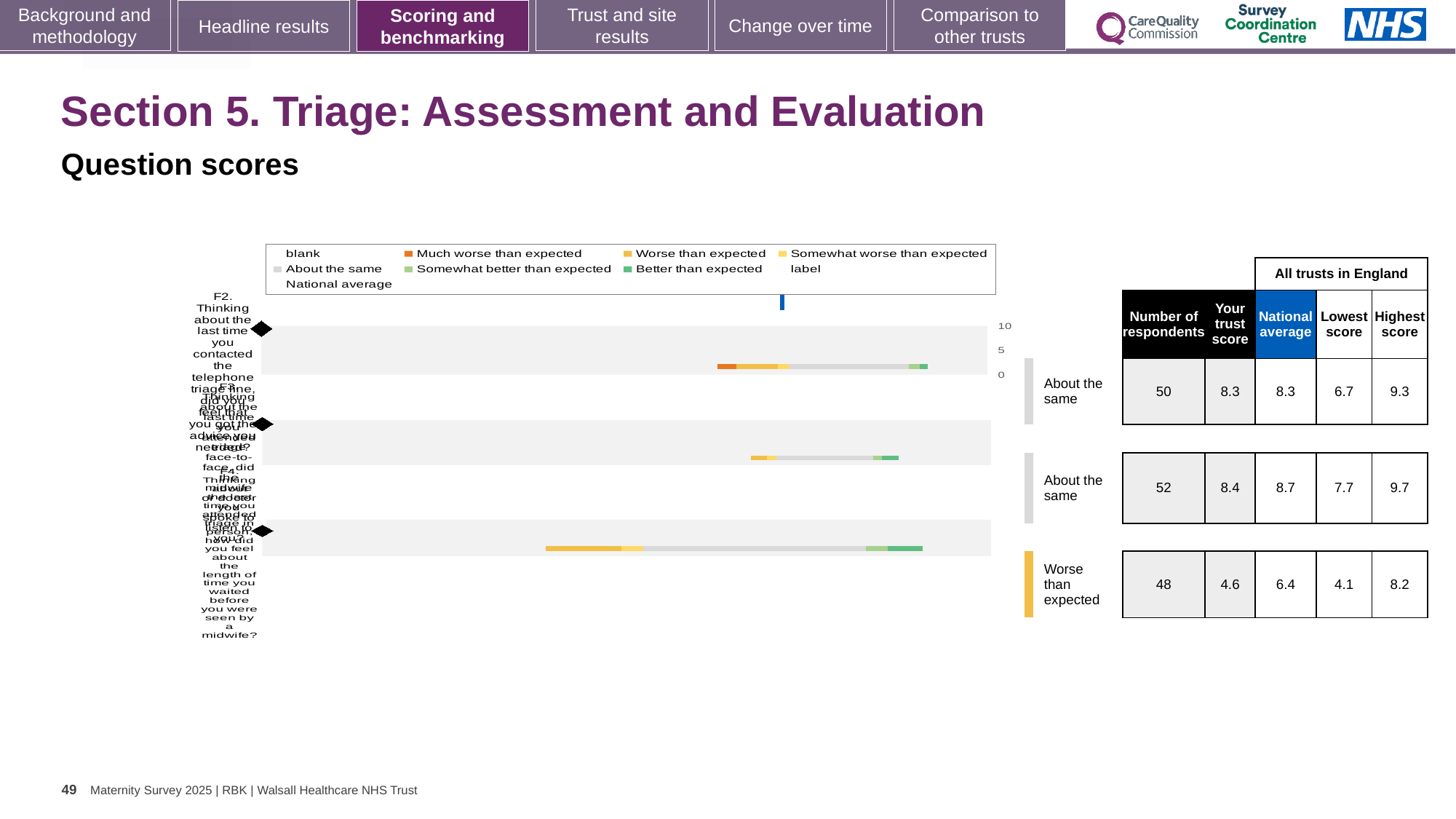
In the table beside the chart, what is the trust score for the third row, labelled 'Worse than expected'? 4.6 In the table beside the chart, is the trust score for the second row larger or smaller than its national average? smaller In the table beside the chart, what is the number of respondents for the first row? 50 What benchmark label is shown for the first row of the chart? About the same What kind of chart is shown on the slide? bar chart In the table beside the chart, what is the highest score for the third row? 8.2 In the table beside the chart, what is the difference between the national average and the trust score for the third row? 1.8 How many question rows (categories) are plotted in the chart? 3 Which legend entry is shown in dark green in the chart's legend? Better than expected In the table beside the chart, what is the national average for the second row? 8.7 Which legend entry is shown in orange in the chart's legend? Much worse than expected In the table beside the chart, which row has the lowest trust score? the third row (Worse than expected)